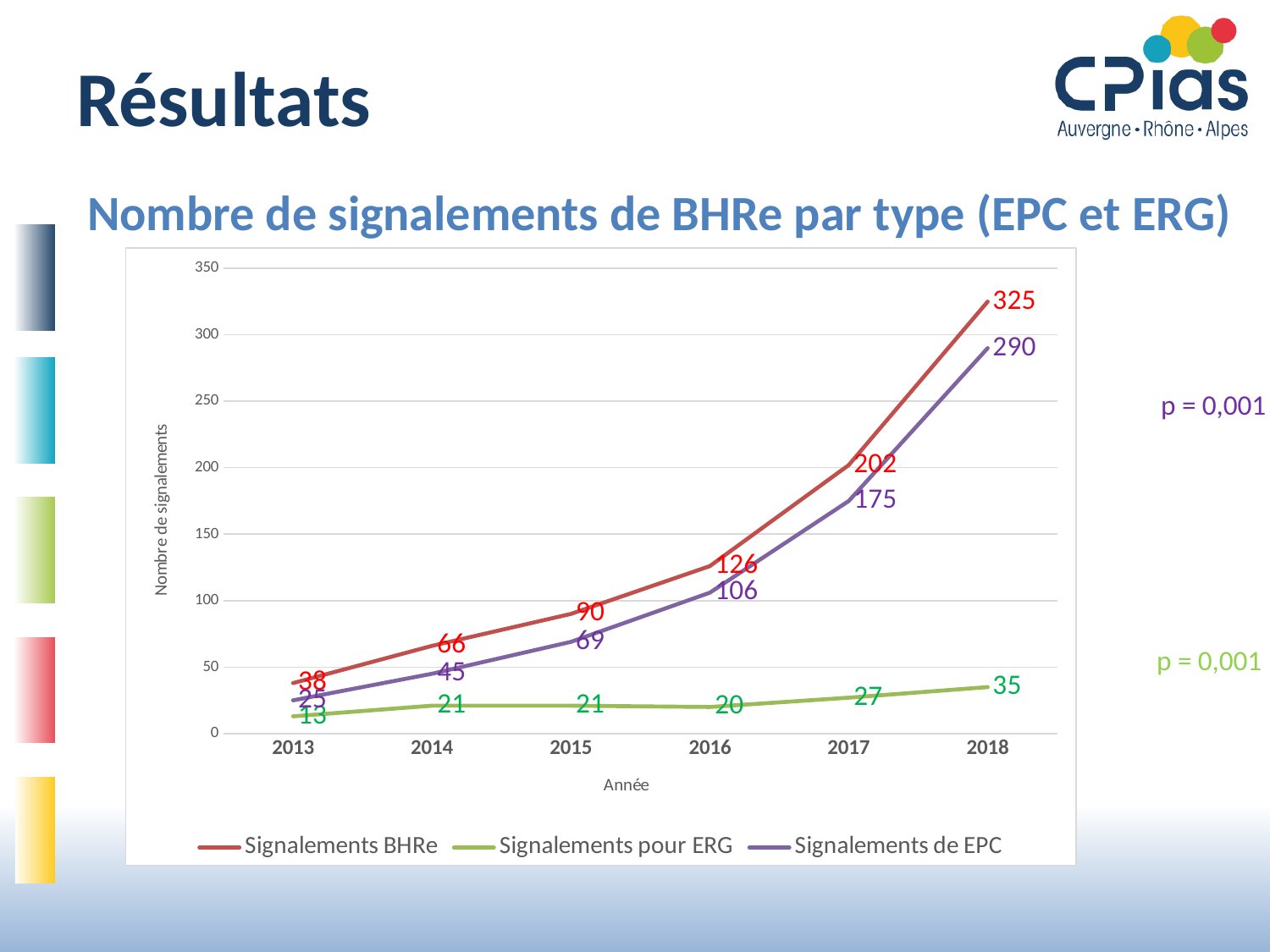
What is the value of Signalements de EPC in 2015? 69 What kind of chart is shown? Line chart How many years are shown on the x axis? 6 In which year is Signalements pour ERG lowest? 2013 Which is larger in 2016: Signalements de EPC or Signalements pour ERG? Signalements de EPC What is the value of Signalements BHRe in 2018? 325 Does Signalements BHRe rise or fall from 2013 to 2018? Rise What is the difference between Signalements BHRe and Signalements de EPC in 2018? 35 How many series does the legend list? 3 What is the value of Signalements de EPC in 2017? 175 What is the value of Signalements pour ERG in 2016? 20 In which year is Signalements pour ERG highest? 2018